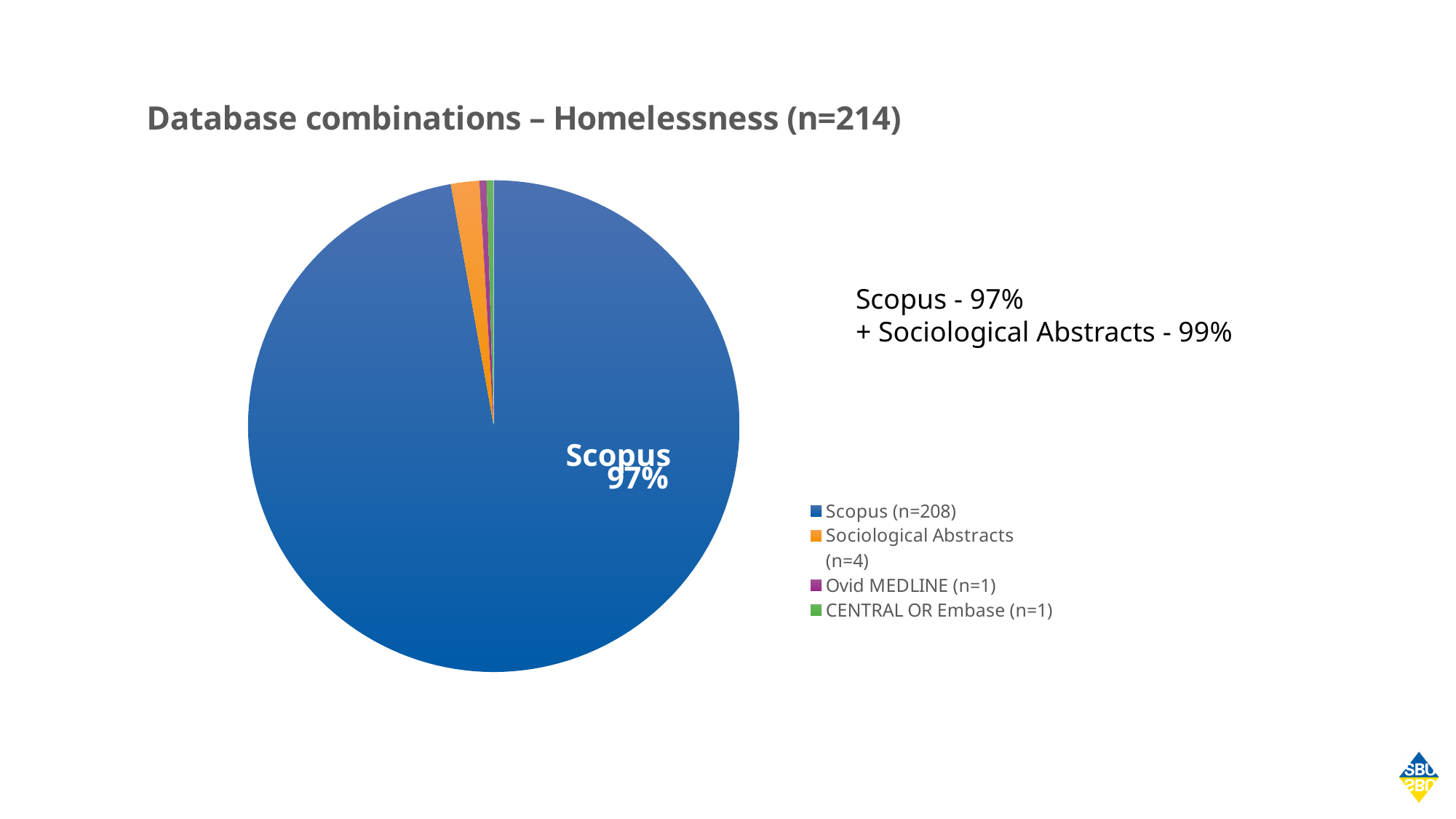
How many slices does the pie chart have? 4 According to the legend, how many records does Ovid MEDLINE account for? n=1 Which has more records, Sociological Abstracts or Ovid MEDLINE? Sociological Abstracts According to the legend, how many records does Sociological Abstracts account for? n=4 What is the title of the chart? Database combinations – Homelessness (n=214) What is the difference in record count between Scopus (n=208) and Sociological Abstracts (n=4)? 204 What is the total number of records (n) given in the chart title? 214 What colour is the Scopus slice in the pie chart? blue What percentage share of the pie is labelled for Scopus? 97% What kind of chart is shown on the slide? pie chart Which database accounts for the largest slice of the pie chart? Scopus According to the legend, how many records does Scopus account for? n=208